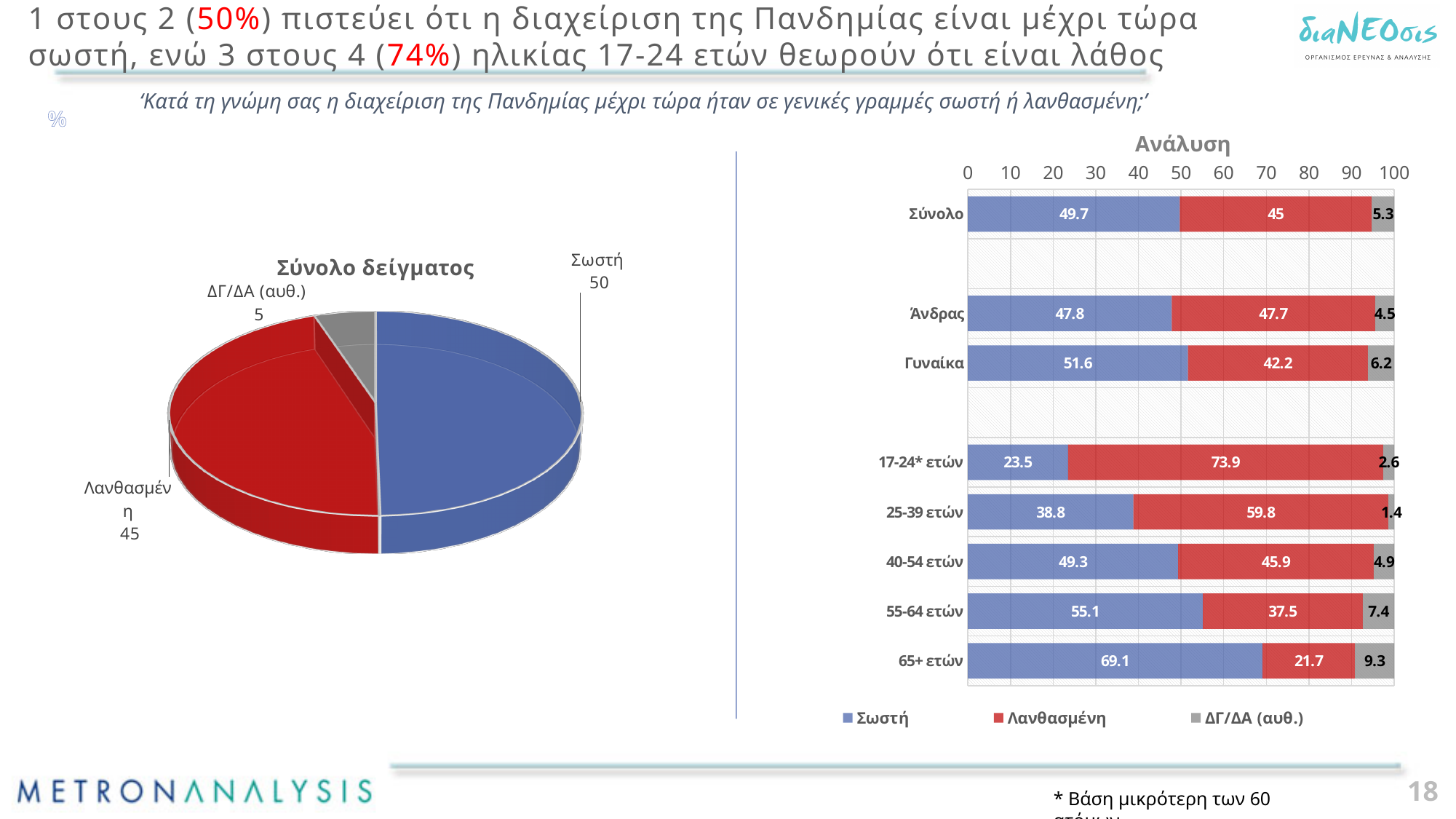
In the 'Ανάλυση' chart, what is the difference between the Σωστή values for Γυναίκα and Άνδρας? 3.8 In the 'Ανάλυση' chart, what is the Λανθασμένη value for 17-24* ετών? 73.9 In the pie chart 'Σύνολο δείγματος', what is the difference between Σωστή and Λανθασμένη? 5 In the 'Ανάλυση' chart, which category has the lowest ΔΓ/ΔΑ (αυθ.) value? 25-39 ετών In the pie chart 'Σύνολο δείγματος', which slice is the smallest? ΔΓ/ΔΑ (αυθ.) How many categories are shown in the 'Ανάλυση' chart? 8 How many series does the legend of the 'Ανάλυση' chart list? 3 In the 'Ανάλυση' chart, which category has the highest Λανθασμένη value? 17-24* ετών In the 'Ανάλυση' chart, what is the Σωστή value for 65+ ετών? 69.1 What kind of chart is the chart titled 'Σύνολο δείγματος'? Pie chart In the pie chart 'Σύνολο δείγματος', what is the value for Λανθασμένη? 45 In the 'Ανάλυση' chart, which is larger: the Σωστή value for 55-64 ετών or for 40-54 ετών? 55-64 ετών